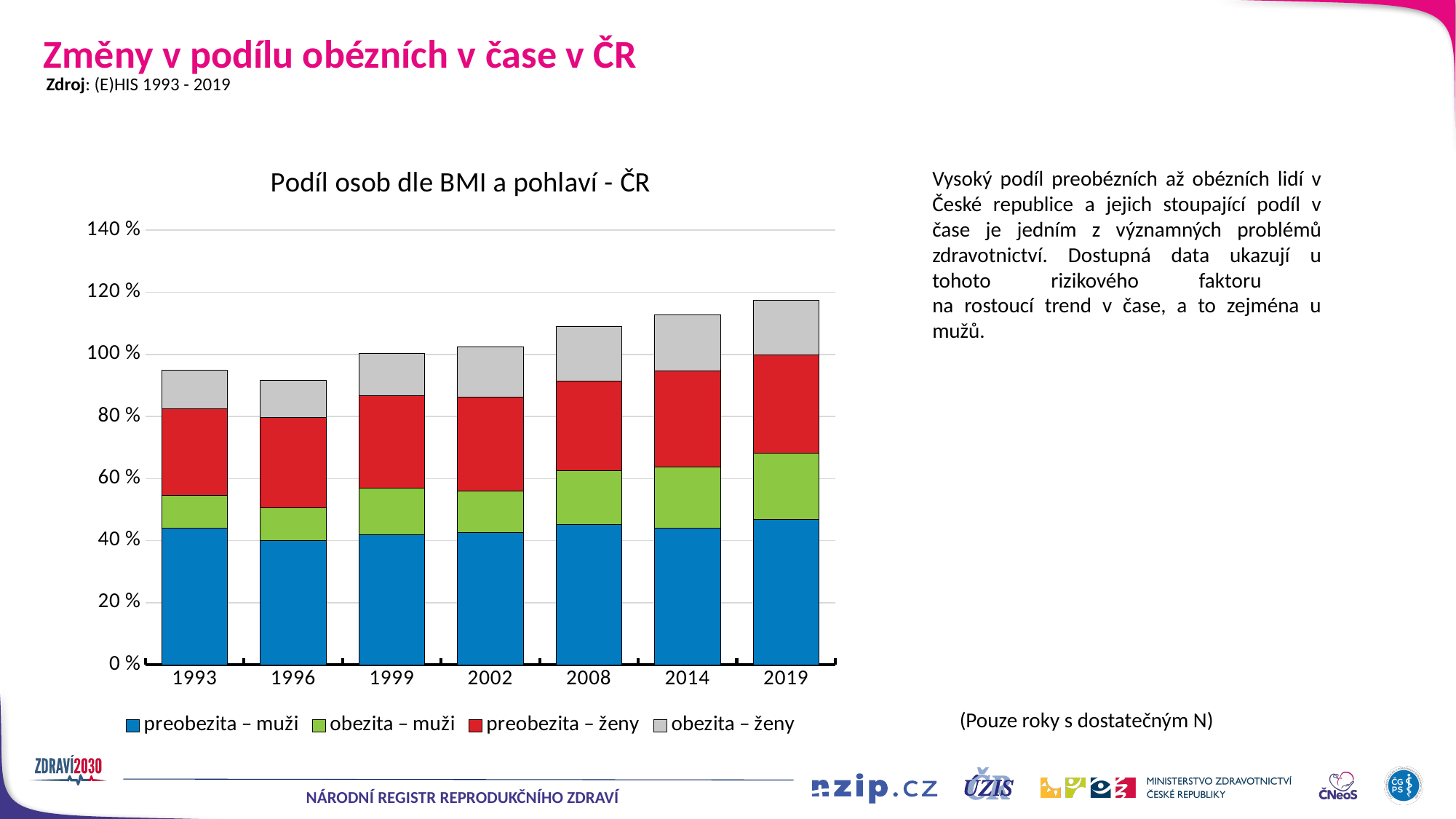
Do the total stacked values generally rise or fall from 1996 to 2019? rise What kind of chart is shown on the slide? stacked bar chart Which year has the larger total stacked bar, 1993 or 2019? 2019 Is the total stacked value for 1996 greater or less than 100 %? less How many years are shown on the x axis of the chart? 7 Is the total stacked value for 2019 greater or less than 100 %? greater Which year has the highest total stacked bar? 2019 How many series does the chart legend list? 4 Which year has the lowest total stacked bar? 1996 Is the value for 'preobezita – muži' in 2019 greater or less than 40 %? greater Which colour represents the series 'preobezita – muži' in the chart? blue What is the title of the chart? Podíl osob dle BMI a pohlaví - ČR